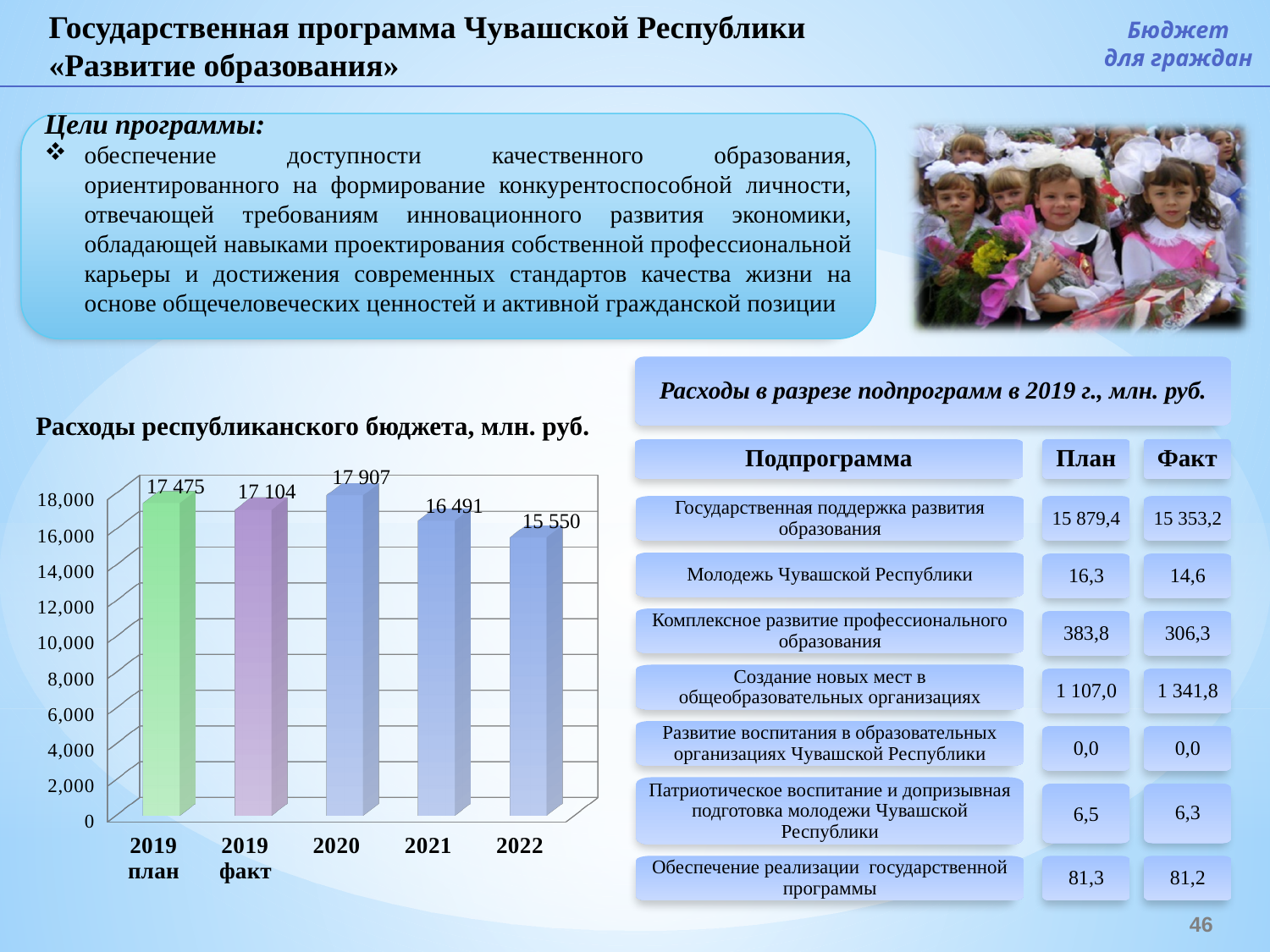
What is the value for '2019 план' in the chart? 17 475 What is the difference between the values for '2019 план' and '2019 факт'? 371 What is the value for 2020 in the chart 'Расходы республиканского бюджета, млн. руб.'? 17 907 How many bars are shown in the chart? 5 Which is larger, the value for 2020 or the value for 2021? 2020 Which category has the highest value in the chart? 2020 What is the difference between the values for 2021 and 2022? 941 What is the value for '2019 факт' in the chart? 17 104 What is the value for 2022 in the chart? 15 550 What kind of chart is shown on the slide? bar chart Do the values rise or fall from 2020 to 2022 in the chart? fall Which category has the lowest value in the chart? 2022